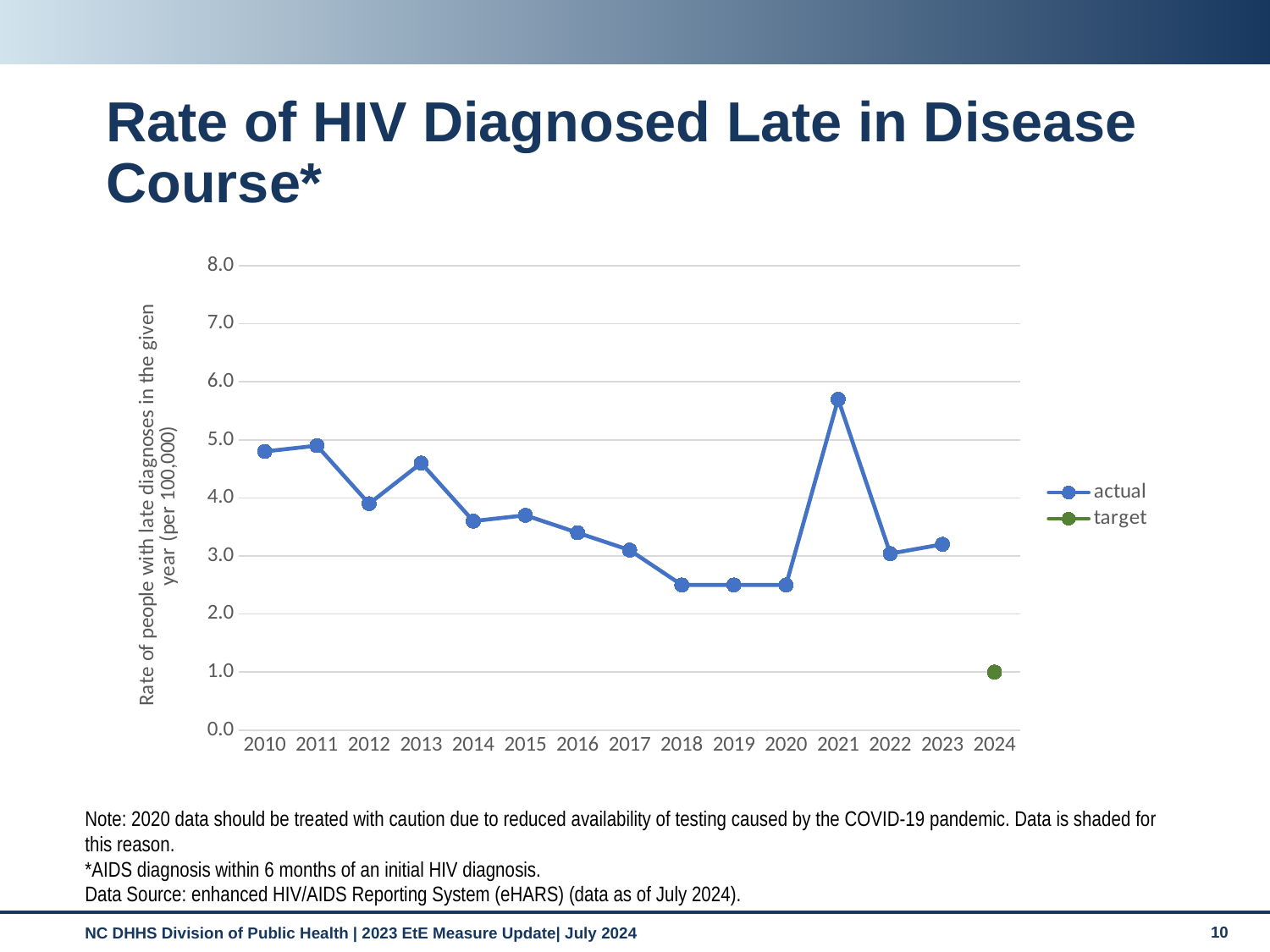
Is the actual value for 2018 greater or less than 3.0? less What are the two series named in the legend? actual and target What is the target value plotted for 2024? 1.0 Which year has the highest value for the actual series? 2021 Do the actual values rise or fall from 2013 to 2018? fall What kind of chart is shown on the slide? line chart How many series does the legend list? 2 How many years are shown on the x axis? 15 Which is larger, the actual value for 2010 or for 2012? 2010 Is the actual value for 2013 greater or less than 4.0? greater Is the actual value for 2021 greater or less than 5.0? greater